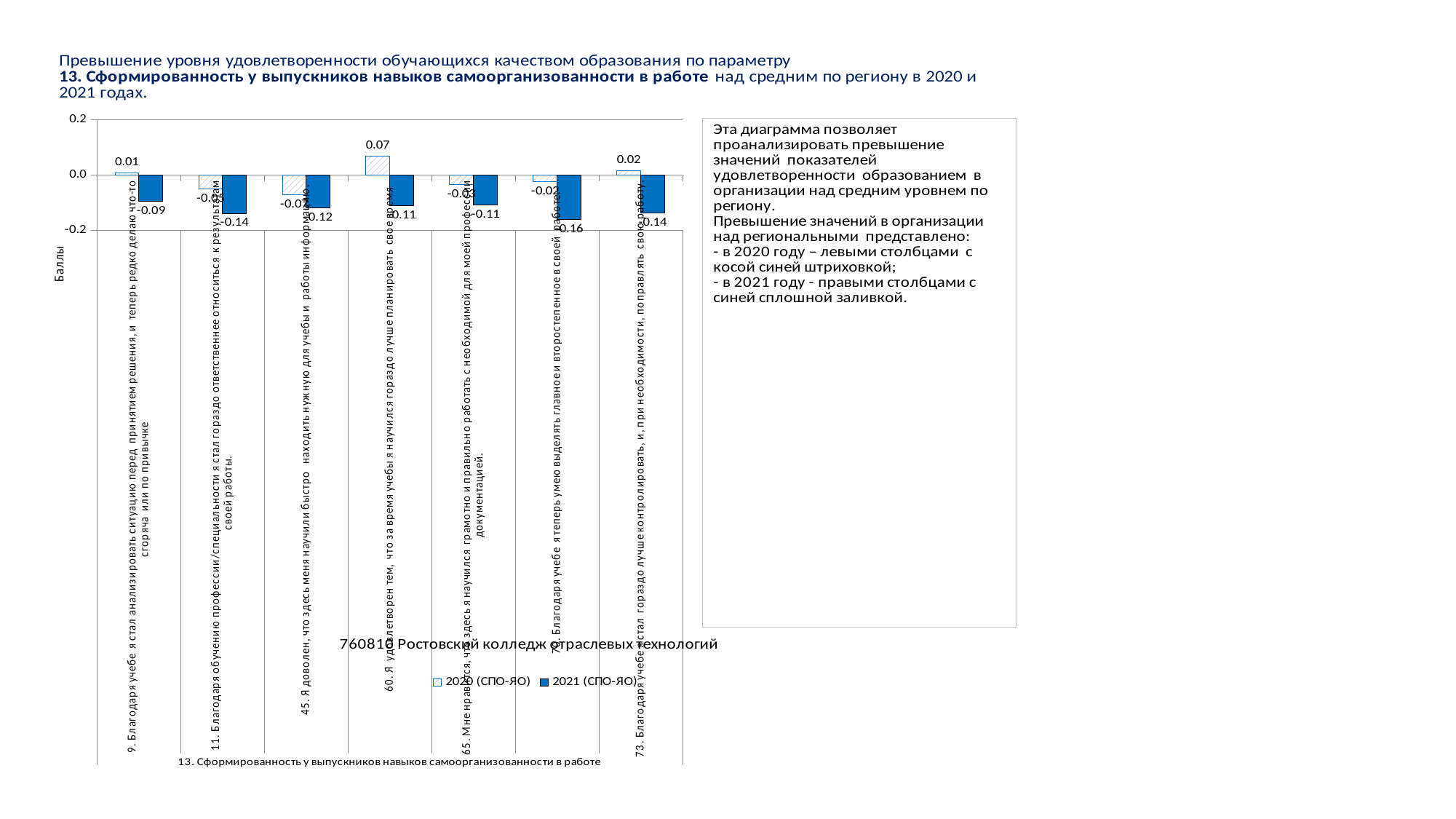
How many categories (statements) are plotted on the x axis? 7 Which statement has the highest 2020 (СПО-ЯО) value? 60. Я удовлетворен тем, что за время учебы я научился гораздо лучше планировать свое время How many series does the legend list? 2 What is the 2021 (СПО-ЯО) value for statement 73 ("Благодаря учебе я стал гораздо лучше контролировать... свою работу")? -0.14 What is the 2020 (СПО-ЯО) value for statement 60 ("Я удовлетворен тем, что за время учебы я научился гораздо лучше планировать свое время")? 0.07 What kind of chart is shown on the slide? bar chart What is the 2021 (СПО-ЯО) value for statement 60 ("Я удовлетворен тем, что за время учебы я научился гораздо лучше планировать свое время")? -0.11 What is the 2020 (СПО-ЯО) value for statement 45 ("Я доволен, что здесь меня научили быстро находить нужную для учебы и работы информацию")? -0.07 Which is larger: the 2021 (СПО-ЯО) value for statement 9 or for statement 11? statement 9 (-0.09) For statement 9 ("Благодаря учебе я стал анализировать ситуацию перед принятием решения..."), what is the difference between the 2020 value and the 2021 value? 0.10 What is the lowest value in the 2021 (СПО-ЯО) series? -0.16 What are the two legend entries of the chart? 2020 (СПО-ЯО) and 2021 (СПО-ЯО)